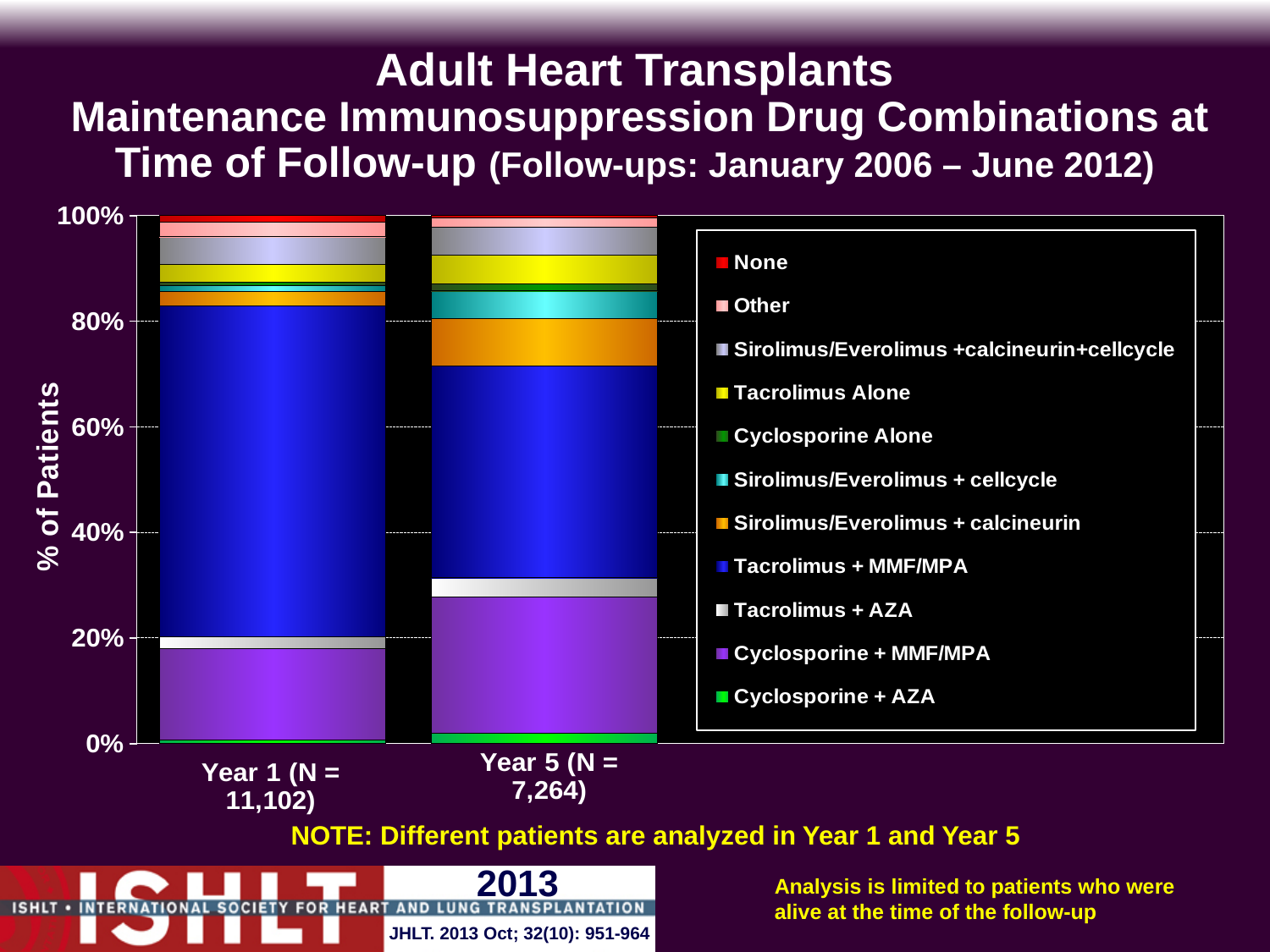
What kind of chart is shown on the slide? Stacked bar chart What is the N shown for the Year 1 category? 11,102 Is the Tacrolimus + MMF/MPA segment for Year 1 greater or less than 40%? greater Which category has the larger Cyclosporine + MMF/MPA segment, Year 1 or Year 5? Year 5 Is the Sirolimus/Everolimus + calcineurin segment for Year 5 greater or less than 20%? less How many series does the legend list? 11 What is the label of the y axis? % of Patients How many bars (categories) are plotted on the chart? 2 Which category has the larger Tacrolimus + MMF/MPA segment, Year 1 or Year 5? Year 1 What is the total of the stacked bar for Year 5? 100% Is the Cyclosporine + MMF/MPA segment for Year 5 greater or less than 20%? greater